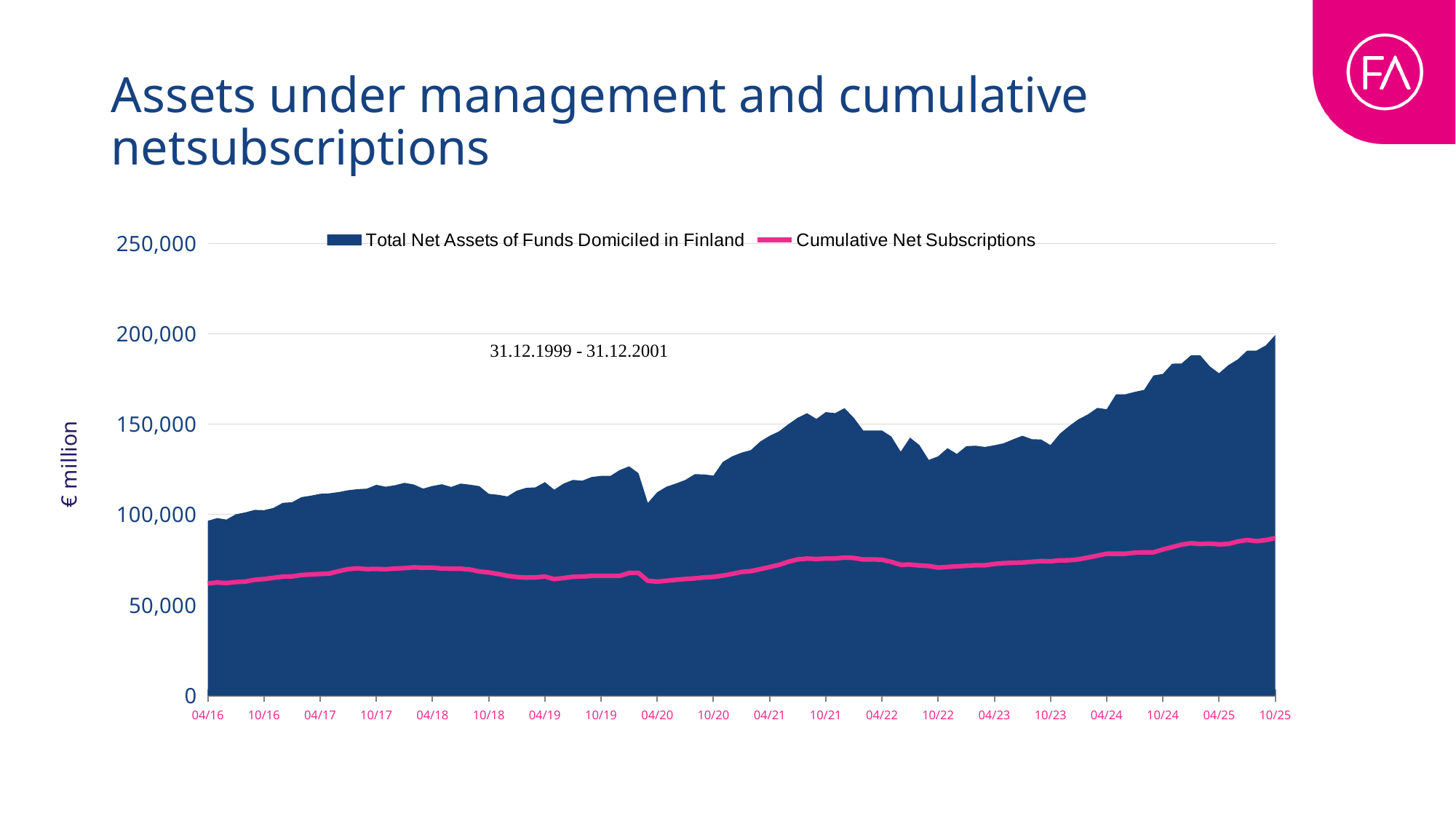
What are the two series named in the chart legend? Total Net Assets of Funds Domiciled in Finland; Cumulative Net Subscriptions How many series does the chart legend list? 2 What kind of chart is shown on the slide? Area chart with a line series At 10/25, which series has the larger value: Total Net Assets of Funds Domiciled in Finland or Cumulative Net Subscriptions? Total Net Assets of Funds Domiciled in Finland Overall, do the values of Total Net Assets of Funds Domiciled in Finland rise or fall from 04/16 to 10/25? rise Is the value of Total Net Assets of Funds Domiciled in Finland at 04/24 greater or less than 150,000? greater Is the value of Total Net Assets of Funds Domiciled in Finland at 10/21 greater or less than 150,000? greater Is the value of Cumulative Net Subscriptions at 10/25 greater or less than 100,000? less What unit is shown on the vertical axis label of the chart? € million How many date labels are shown along the x axis of the chart? 20